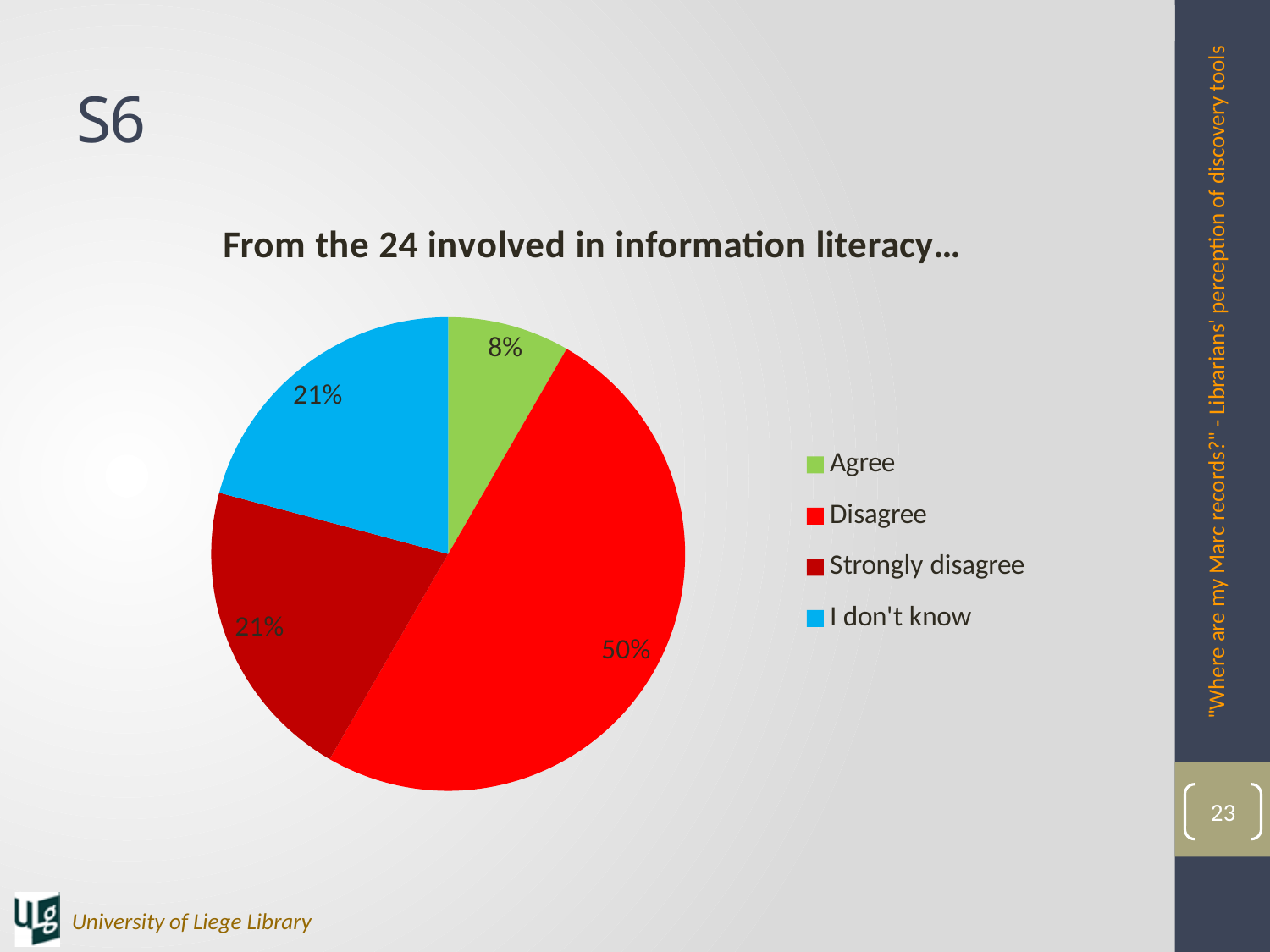
Which category has the smallest share of the pie? Agree What colour represents I don't know in the chart? light blue What type of chart is shown on the slide? pie chart Which is larger, the share for Disagree or the share for Strongly disagree? Disagree How many categories does the legend list? 4 What percentage of the pie is labelled Disagree? 50% What is the title of the chart? From the 24 involved in information literacy… Which category has the largest share of the pie? Disagree What percentage of the pie is labelled Strongly disagree? 21% What percentage of the pie is labelled I don't know? 21% What is the difference in percentage points between Disagree and Agree? 42 What percentage of the pie is labelled Agree? 8%